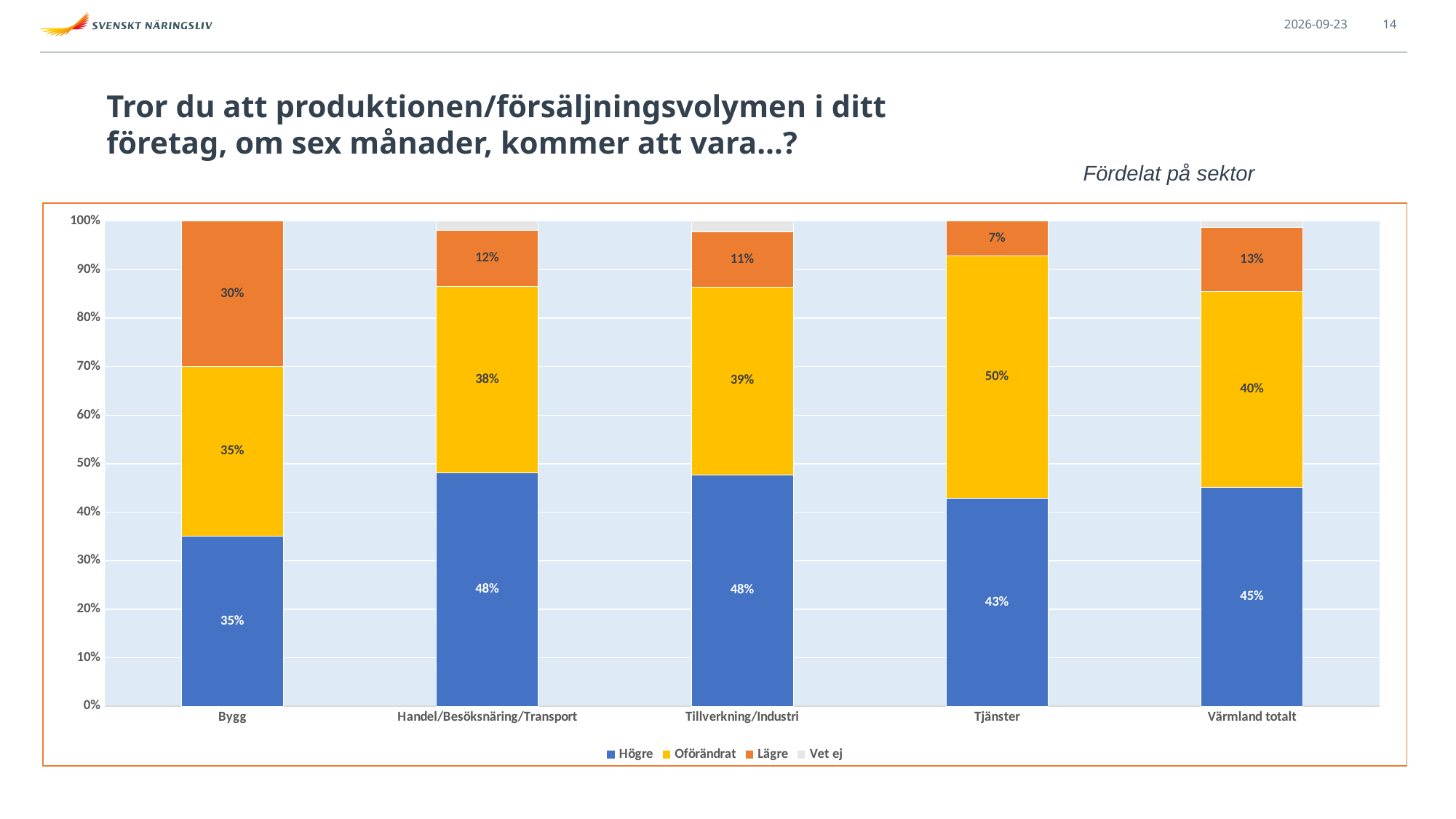
What is the Högre value for Tillverkning/Industri? 48% What type of chart is shown? Stacked bar chart What is the Lägre value for Värmland totalt? 13% Which sector has the lowest Lägre share? Tjänster What is the difference in percentage points between the Lägre share for Bygg and for Tjänster? 23 percentage points What percentage of Bygg respondents answered Högre? 35% How many series does the legend list? 4 Which is larger: the Högre share for Tjänster or for Värmland totalt? Värmland totalt What is the Oförändrat value for Tjänster? 50% Which sector has the highest Oförändrat share? Tjänster Which sector has the highest Lägre share? Bygg How many sectors are shown on the x axis? 5